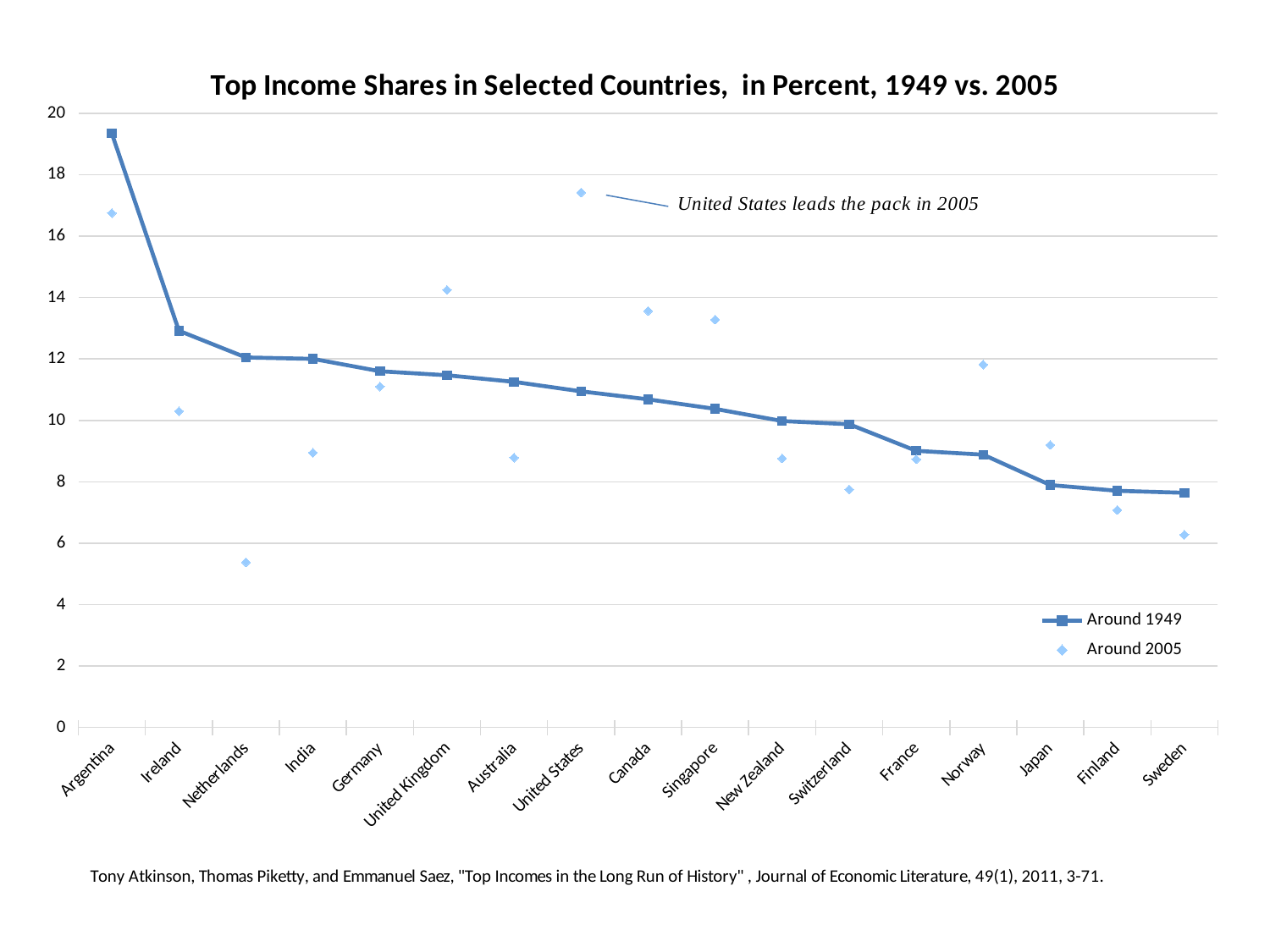
Is the Around 2005 value for the Netherlands greater or less than 6? less Is the Around 2005 value for the United States greater or less than 16? greater What does the annotation next to the United States 2005 point say? United States leads the pack in 2005 Which country has the lowest top income share in the Around 2005 series? Netherlands How many countries are shown on the x axis? 17 For the United Kingdom, which is larger: the Around 1949 value or the Around 2005 value? Around 2005 What kind of chart is shown on the slide? line chart Is the Around 1949 value for Argentina greater or less than 18? greater Do the Around 1949 values rise or fall moving from Argentina to Sweden along the x axis? fall Which country has the highest top income share in the Around 2005 series? United States Which country has the highest top income share in the Around 1949 series? Argentina How many series does the legend list? 2